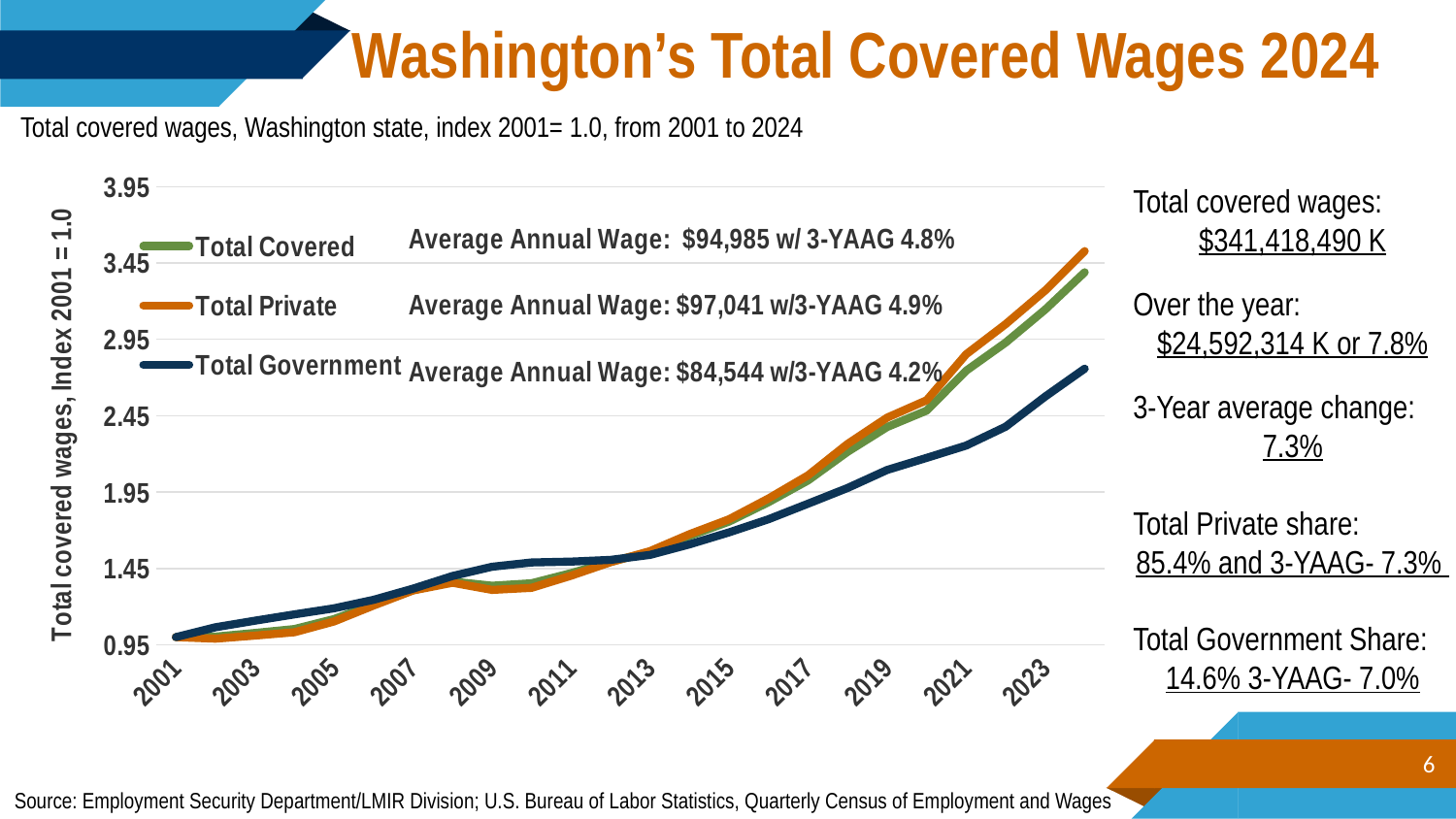
Is the value for Total Government in 2023 greater or less than 2.45? greater What is the label on the y axis of the chart? Total covered wages, Index 2001 = 1.0 In 2009, which is higher: Total Government or Total Private? Total Government Which series has the lowest index value in 2024? Total Government How many year labels are shown on the x axis? 12 Is the value for Total Government in 2024 greater or less than 2.95? less Is the value for Total Covered in 2015 greater or less than 1.95? less What average annual wage is printed next to the Total Government legend entry? $84,544 Do the Total Covered wages index values generally rise or fall from 2001 to 2024? Rise How many series does the legend list? 3 Which series has the highest index value in 2024? Total Private What type of chart is shown on the slide? Line chart